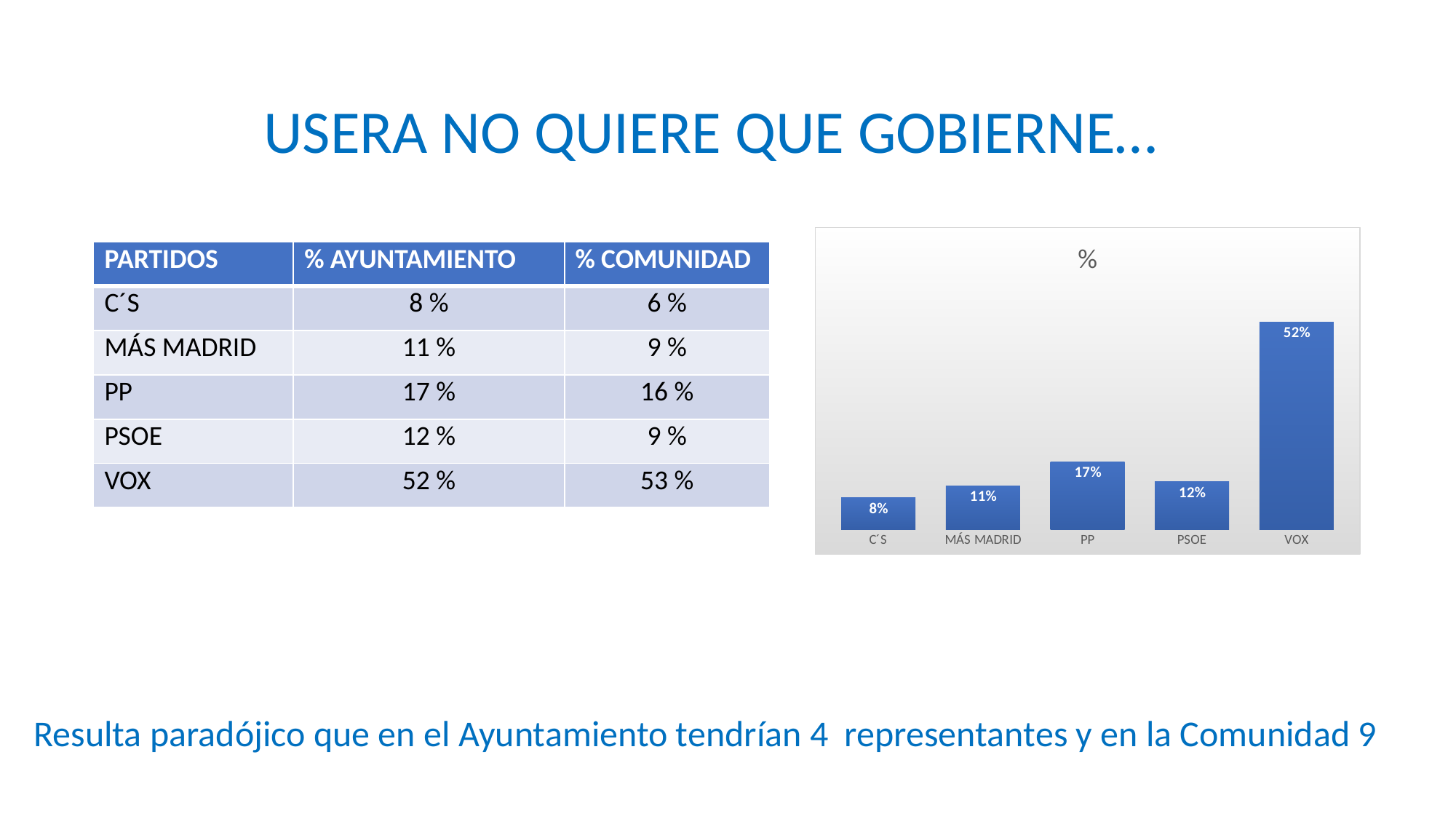
What kind of chart is shown on the slide? Bar chart What is the value for PP in the chart? 17% What is the value for VOX in the chart? 52% What is the difference between the values for PSOE and MÁS MADRID in the chart? 1% Which category has the highest value in the chart? VOX What is the value for MÁS MADRID in the chart? 11% What is the difference between the values for VOX and PP in the chart? 35% Which is larger in the chart, the value for PP or the value for PSOE? PP What is the value for C´S in the chart? 8% What is the title of the chart? % How many categories are shown in the chart? 5 Which category has the lowest value in the chart? C´S